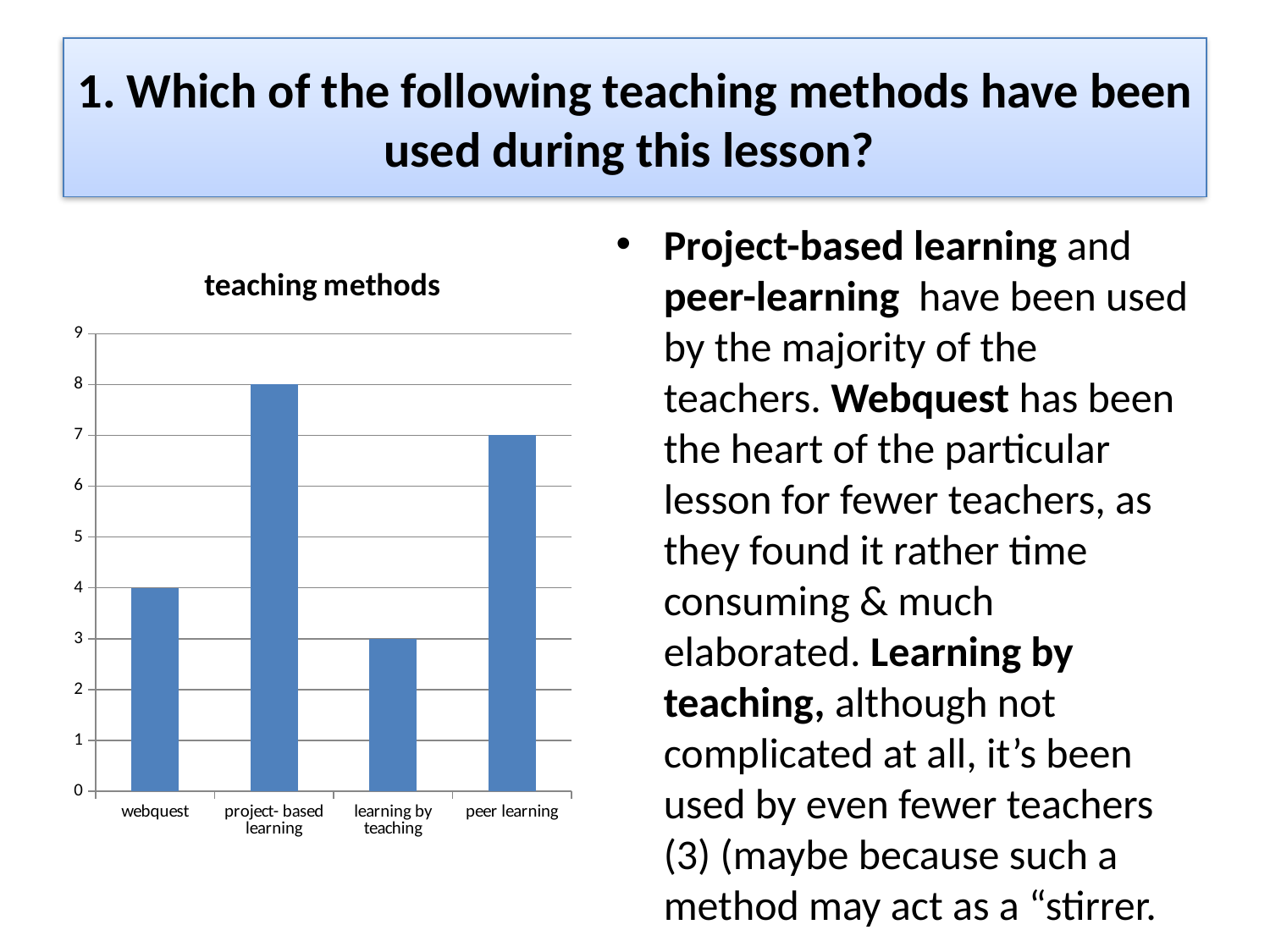
Which teaching method has the lowest value? learning by teaching What is the value for learning by teaching? 3 Which teaching method has the highest value? project-based learning What is the difference between the values for project-based learning and webquest? 4 How many teaching methods (categories) are shown in the chart? 4 What is the title of the chart? teaching methods Is the value for learning by teaching greater or less than 5? less What is the value for project-based learning? 8 What kind of chart is shown on the slide? bar chart Which is larger, the value for peer learning or the value for webquest? peer learning What is the value for webquest? 4 What is the value for peer learning? 7